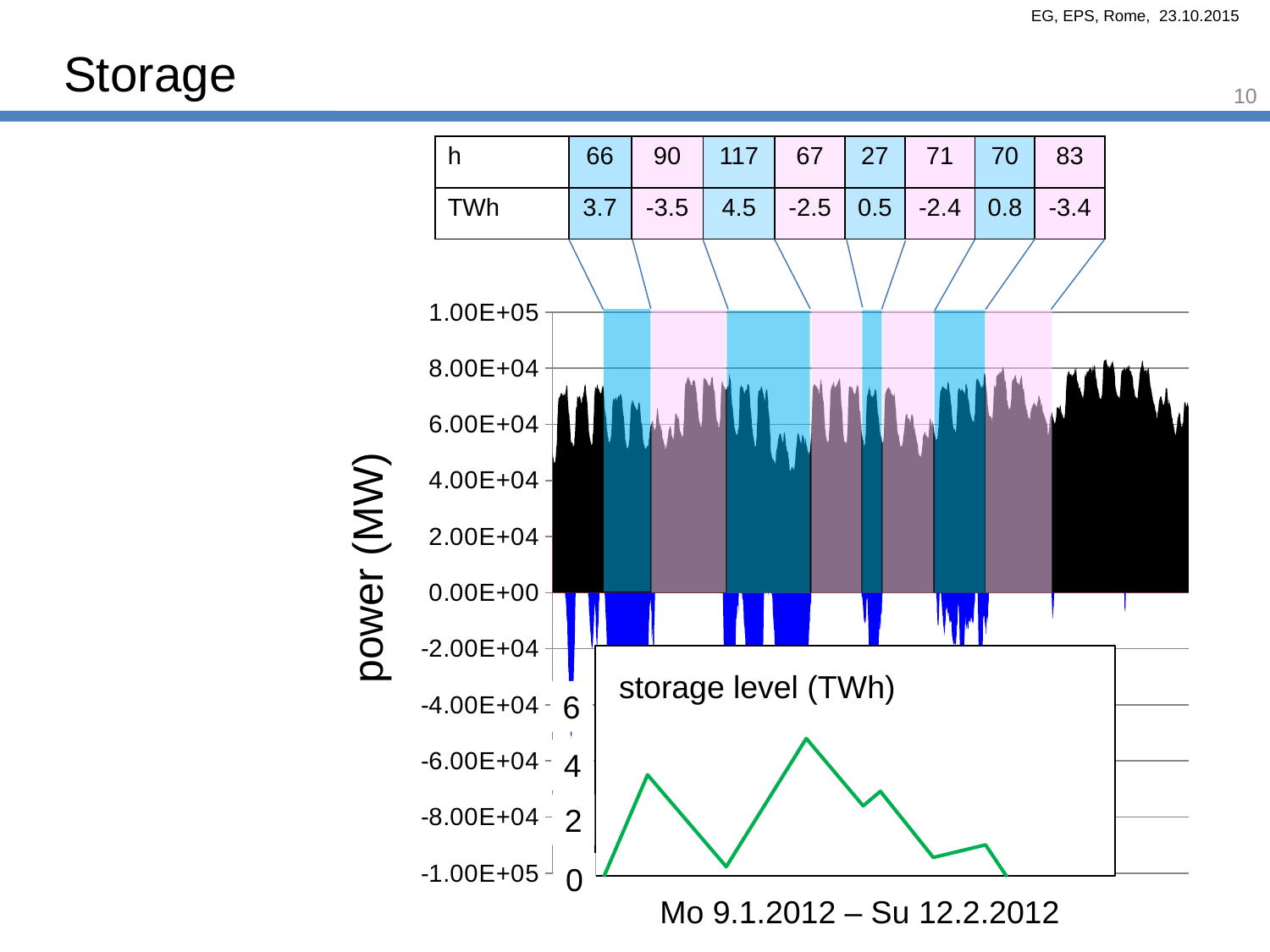
What is the y-axis label of the main chart? power (MW) In the table above the main chart, what is the shortest period in hours (h)? 27 What date range is shown on the x-axis of the main chart? Mo 9.1.2012 – Su 12.2.2012 In the inset "storage level (TWh)" chart, is the highest point of the line greater or less than 4? greater In the table above the main chart, how many periods (columns of values) are listed? 8 In the table above the main chart, what is the longest period in hours (h)? 117 What kind of chart is the inset chart titled "storage level (TWh)"? line chart In the table above the main chart, what is the difference in hours between the 117 h period and the 90 h period? 27 In the table above the main chart, what is the lowest TWh value? -3.5 In the table above the main chart, which period has the largest TWh value? the 117 h period (4.5 TWh) In the table above the main chart, which is larger: the TWh value for the 66 h period or for the 117 h period? 117 h period (4.5) In the table above the main chart, what is the TWh value for the period of 66 h? 3.7